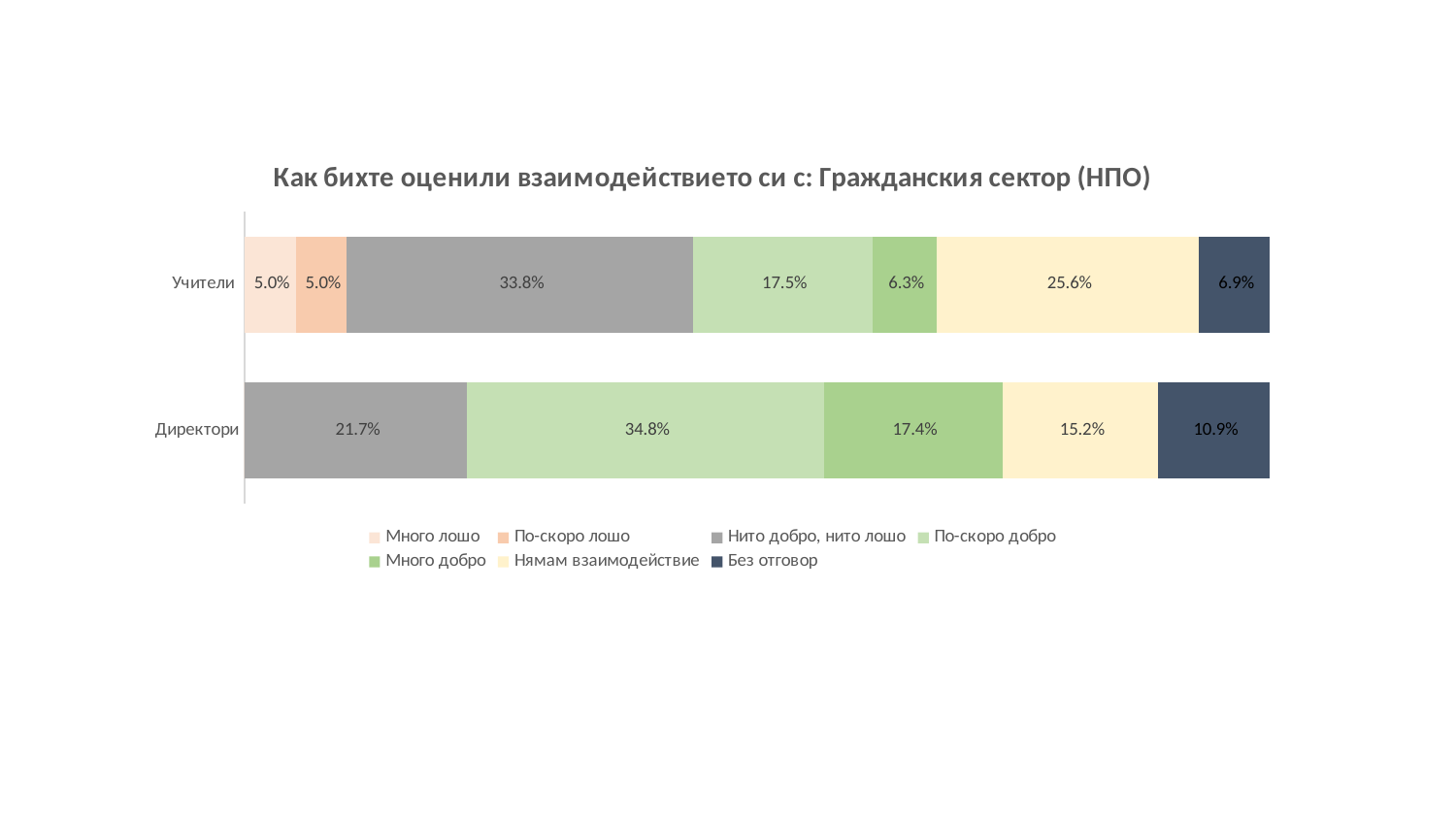
What is the difference between the 'Много добро' values for Директори and Учители? 11.1% What is the value of 'Нито добро, нито лошо' for Учители? 33.8% Which segment is the largest in the Учители bar? Нито добро, нито лошо What is the value of 'По-скоро добро' for Директори? 34.8% What is the value of 'Нямам взаимодействие' for Учители? 25.6% How many series does the legend list? 7 Which is larger: 'Нямам взаимодействие' for Учители or for Директори? Учители Which segment is the largest in the Директори bar? По-скоро добро What is the title of the chart? Как бихте оценили взаимодействието си с: Гражданския сектор (НПО) How many categories (bars) are shown on the chart? 2 What is the value of 'Без отговор' for Директори? 10.9% What type of chart is shown on the slide? Stacked bar chart